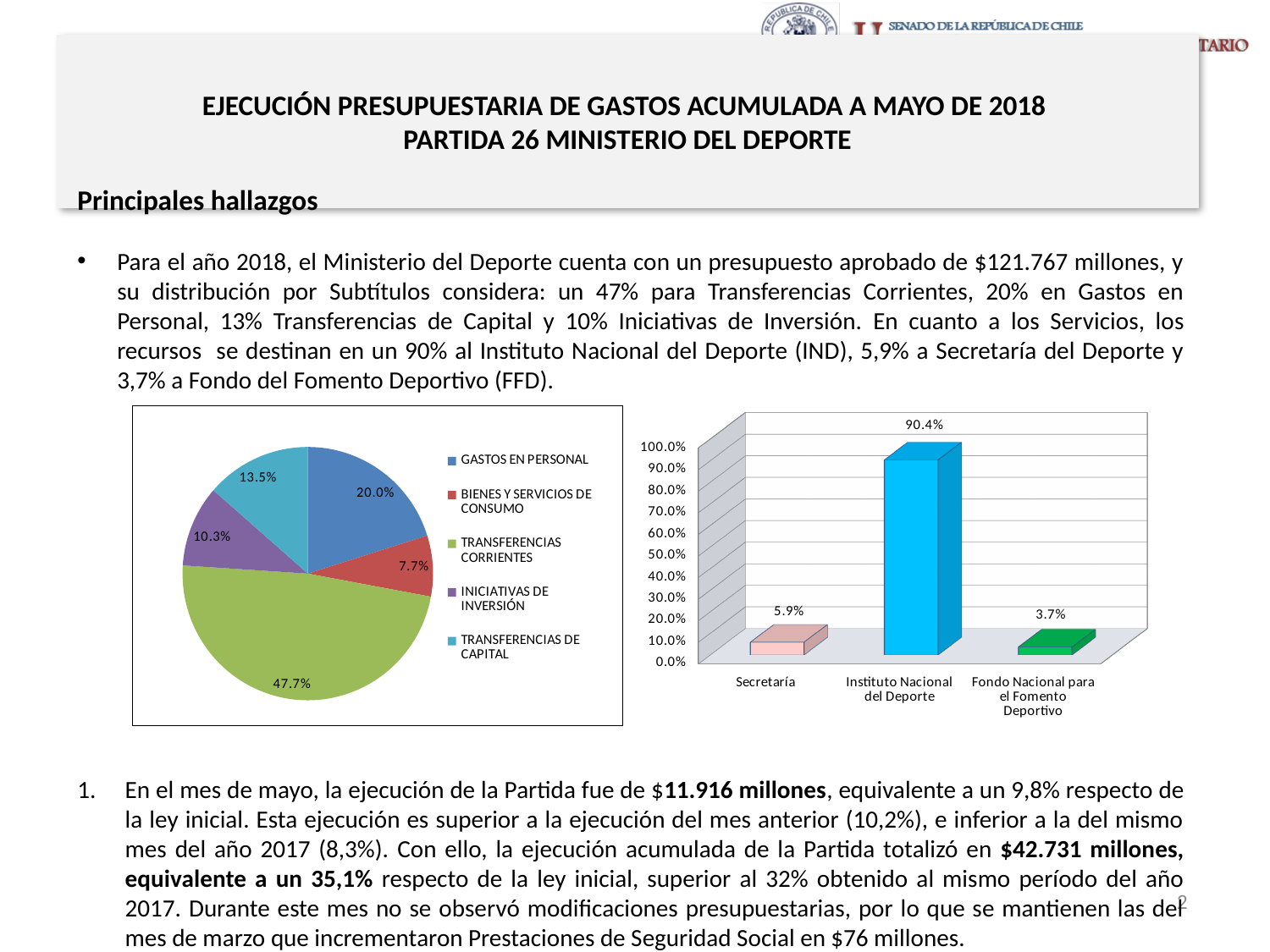
In the pie chart on the left, what share is shown for BIENES Y SERVICIOS DE CONSUMO? 7.7% In the bar chart on the right, which category has the lowest value? Fondo Nacional para el Fomento Deportivo What type of chart is shown on the right side of the slide? Bar chart In the bar chart on the right, what is the difference between the values for Secretaría and Fondo Nacional para el Fomento Deportivo? 2.2% In the pie chart on the left, what share is shown for GASTOS EN PERSONAL? 20.0% In the pie chart on the left, what is the difference between the shares of TRANSFERENCIAS DE CAPITAL and INICIATIVAS DE INVERSIÓN? 3.2% In the bar chart on the right, what is the value for Instituto Nacional del Deporte? 90.4% In the pie chart on the left, which category has the smallest slice? BIENES Y SERVICIOS DE CONSUMO In the pie chart on the left, which category has the largest slice? TRANSFERENCIAS CORRIENTES In the pie chart on the left, how many categories does the legend list? 5 In the pie chart on the left, what share is shown for TRANSFERENCIAS CORRIENTES? 47.7% In the bar chart on the right, what is the value for Fondo Nacional para el Fomento Deportivo? 3.7%